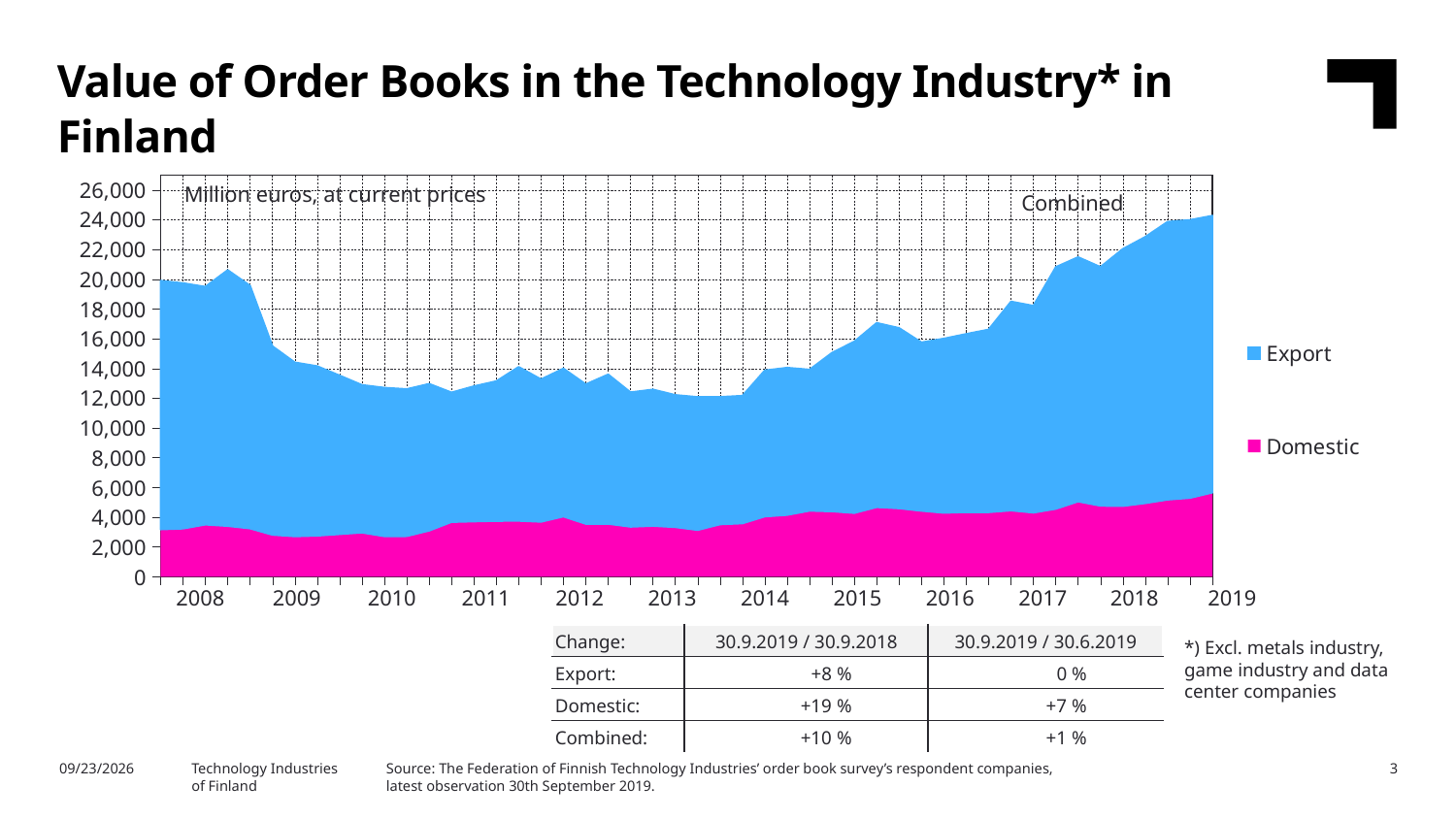
Is the combined value at the start of 2008 greater or less than 22,000? less Is the Domestic value at the end of the series in 2019 greater or less than 4,000? greater Is the combined value at the end of the series in 2019 greater or less than 22,000? greater What are the two series named in the chart legend? Export and Domestic What unit does the chart's annotation say the values are in? Million euros, at current prices How many series does the chart legend list? 2 Does the combined value rise or fall from 2017 to 2019? Rise Which series is larger throughout the chart, Export or Domestic? Export Does the combined value rise or fall from 2008 to 2009? Fall What kind of chart is shown on the slide? Area chart How many year labels are shown on the x axis? 12